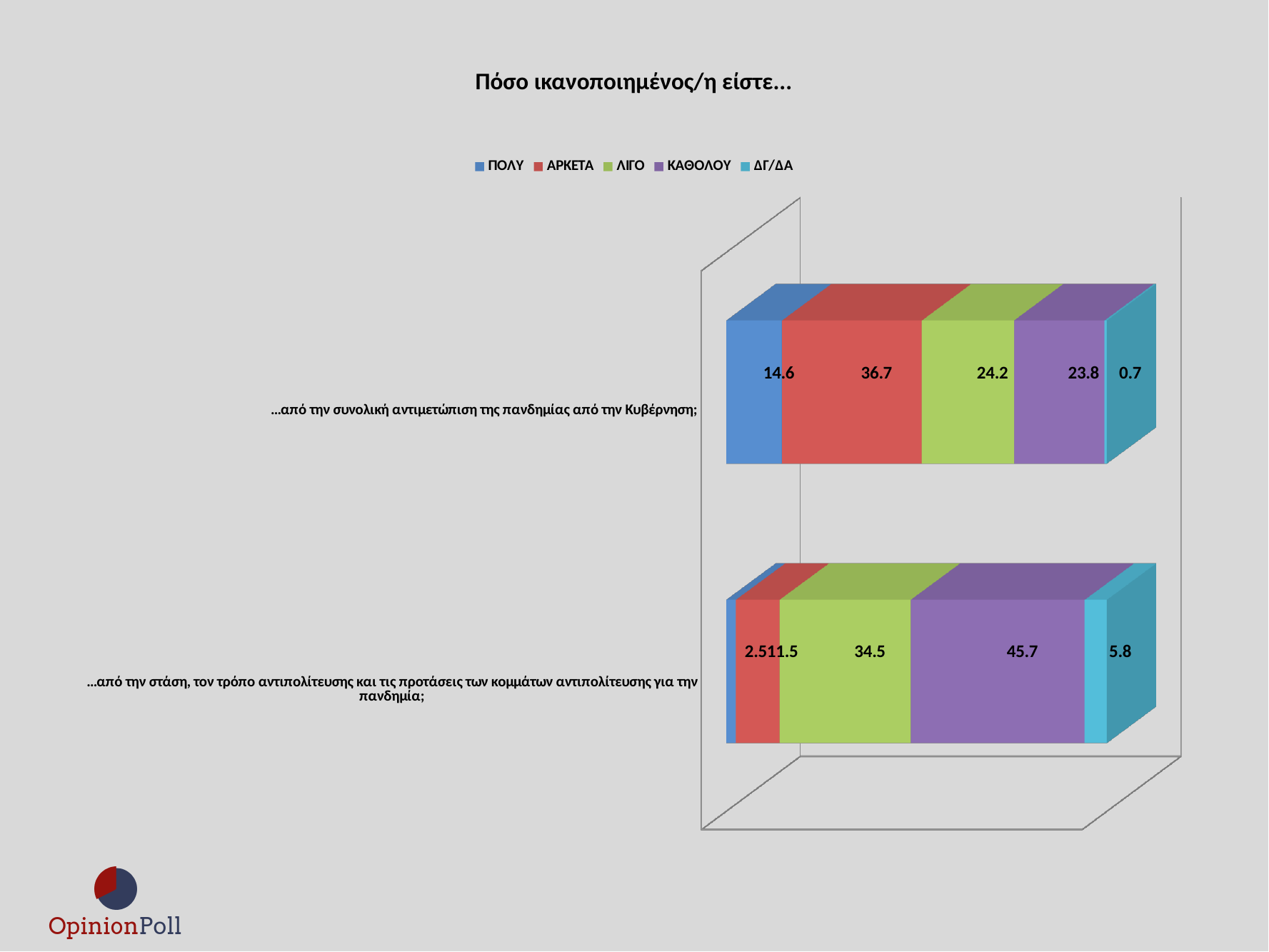
What is the ΑΡΚΕΤΑ value for the bar about the Government's overall handling of the pandemic (…από την συνολική αντιμετώπιση της πανδημίας από την Κυβέρνηση;)? 36.7 Which series has the largest value in the bar about the Government's overall handling of the pandemic? ΑΡΚΕΤΑ Which is larger: the ΛΙΓΟ value for the Government bar or the ΛΙΓΟ value for the opposition bar? The opposition bar (34.5) What is the difference between the ΚΑΘΟΛΟΥ values for the opposition bar (45.7) and the Government bar (23.8)? 21.9 How many categories (bars) are plotted in the chart? 2 Which series has the smallest value in the bar about the opposition parties' stance and proposals on the pandemic? ΠΟΛΥ What is the ΠΟΛΥ value for the bar about the opposition parties' stance and proposals on the pandemic? 2.5 What is the ΔΓ/ΔΑ value for the bar about the Government's overall handling of the pandemic? 0.7 What is the ΚΑΘΟΛΟΥ value for the bar about the opposition parties' stance and proposals on the pandemic? 45.7 How many series does the legend list? 5 What is the title of the chart? Πόσο ικανοποιημένος/η είστε… What kind of chart is shown on the slide? Stacked bar chart